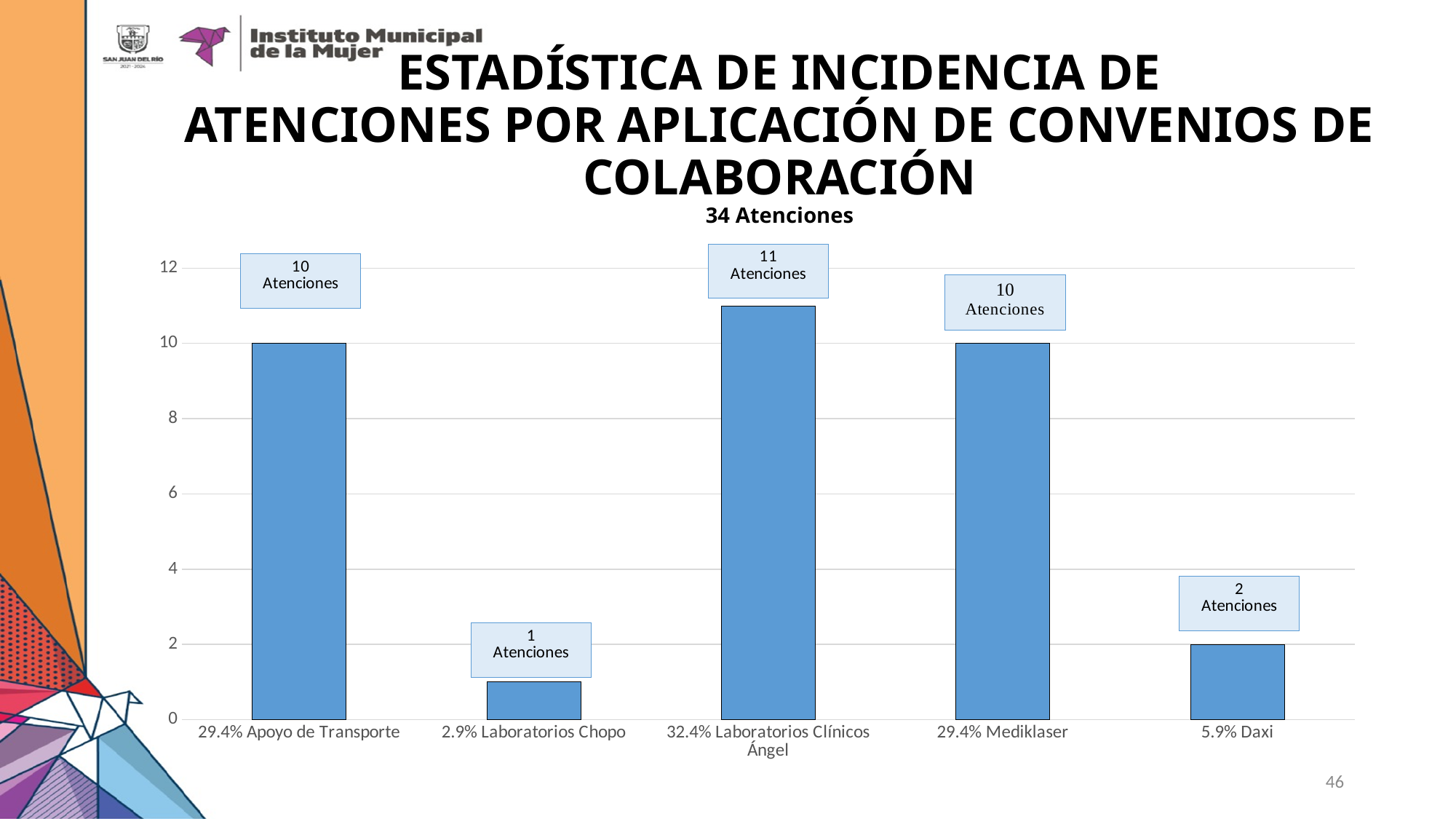
How many atenciones are shown for Laboratorios Clínicos Ángel? 11 Atenciones What is the difference in atenciones between Laboratorios Clínicos Ángel and Daxi? 9 What kind of chart is shown on the slide? Bar chart What is the highest value shown on the vertical axis? 12 Which has more atenciones, Apoyo de Transporte or Daxi? Apoyo de Transporte How many atenciones are shown for Laboratorios Chopo? 1 Atenciones How many categories are plotted on the chart? 5 Which category has the lowest number of atenciones? Laboratorios Chopo What percentage share is shown in the axis label for Mediklaser? 29.4% Which category has the highest number of atenciones? Laboratorios Clínicos Ángel What is the chart's subtitle indicating the total number of atenciones? 34 Atenciones How many atenciones are shown for Daxi? 2 Atenciones